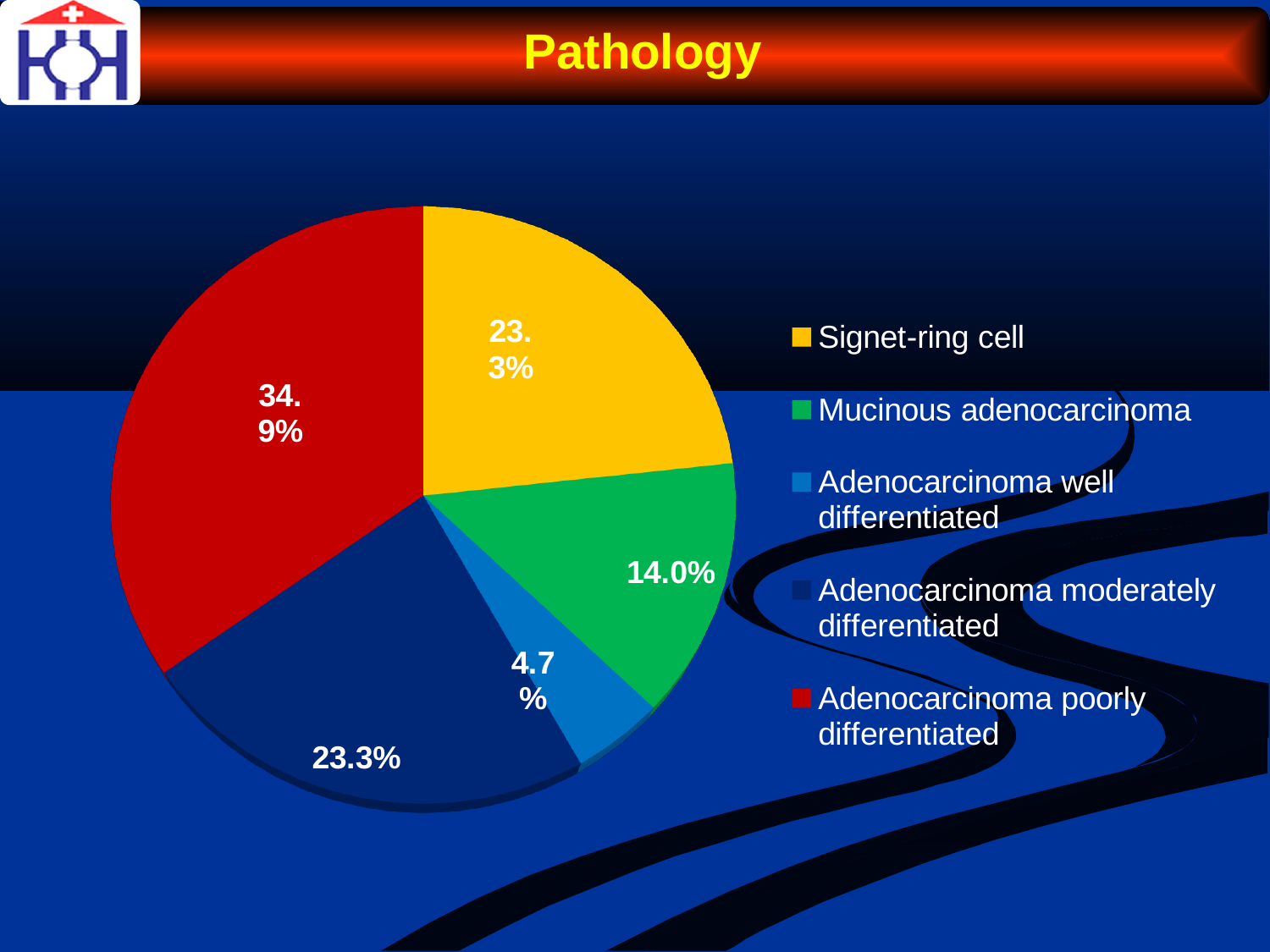
What share of the pie is Adenocarcinoma poorly differentiated? 34.9% Which category has the smallest slice of the pie? Adenocarcinoma well differentiated Which category has the largest slice of the pie? Adenocarcinoma poorly differentiated What colour is the slice for Signet-ring cell? yellow What is the title of the slide containing the chart? Pathology What share of the pie is Adenocarcinoma well differentiated? 4.7% What share of the pie is Signet-ring cell? 23.3% How many categories does the legend list? 5 What is the difference between the shares of Adenocarcinoma poorly differentiated and Mucinous adenocarcinoma? 20.9% What type of chart is shown on the slide? pie chart Which is larger, the share for Mucinous adenocarcinoma or the share for Adenocarcinoma well differentiated? Mucinous adenocarcinoma